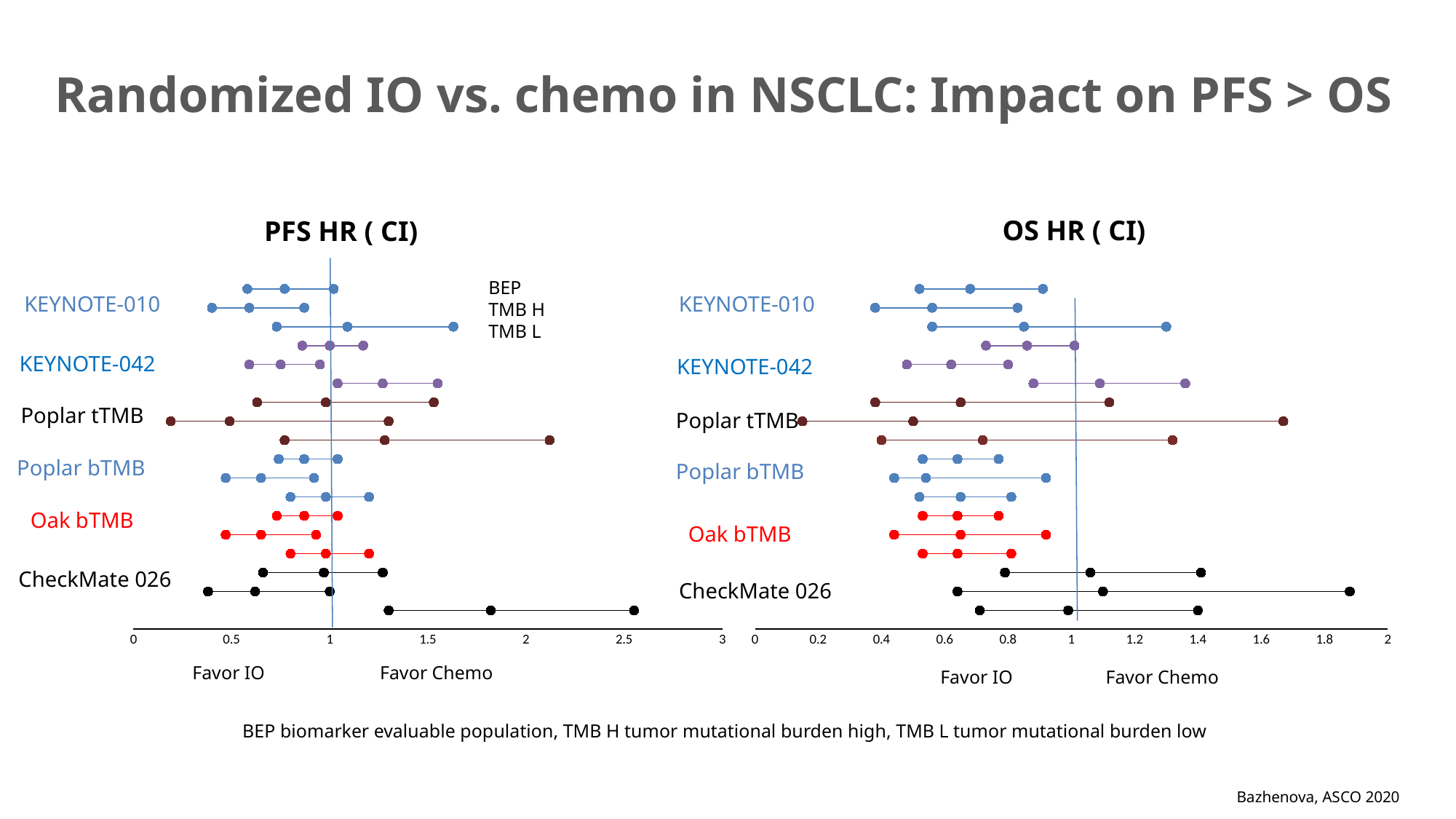
In the "OS HR ( CI)" chart, is the point estimate for KEYNOTE-010 BEP greater or less than 0.8? less How many trials are labelled on the y axis of the "OS HR ( CI)" chart? 6 In the "PFS HR ( CI)" chart, is the point estimate for CheckMate 026 TMB L greater or less than 1.5? greater In the "PFS HR ( CI)" chart, which has the larger point estimate: CheckMate 026 TMB L or Oak bTMB TMB H? CheckMate 026 TMB L How many subgroups (BEP, TMB H, TMB L) are listed in the legend of the "PFS HR ( CI)" chart? 3 What label appears under the left side of the x axis of the "PFS HR ( CI)" chart? Favor IO In the "PFS HR ( CI)" chart, is the upper confidence limit for Poplar tTMB TMB L greater or less than 2? greater How many trials are labelled on the y axis of the "PFS HR ( CI)" chart? 6 What kind of chart is the left chart titled "PFS HR ( CI)"? forest plot What is the title of the right-hand chart? OS HR ( CI)